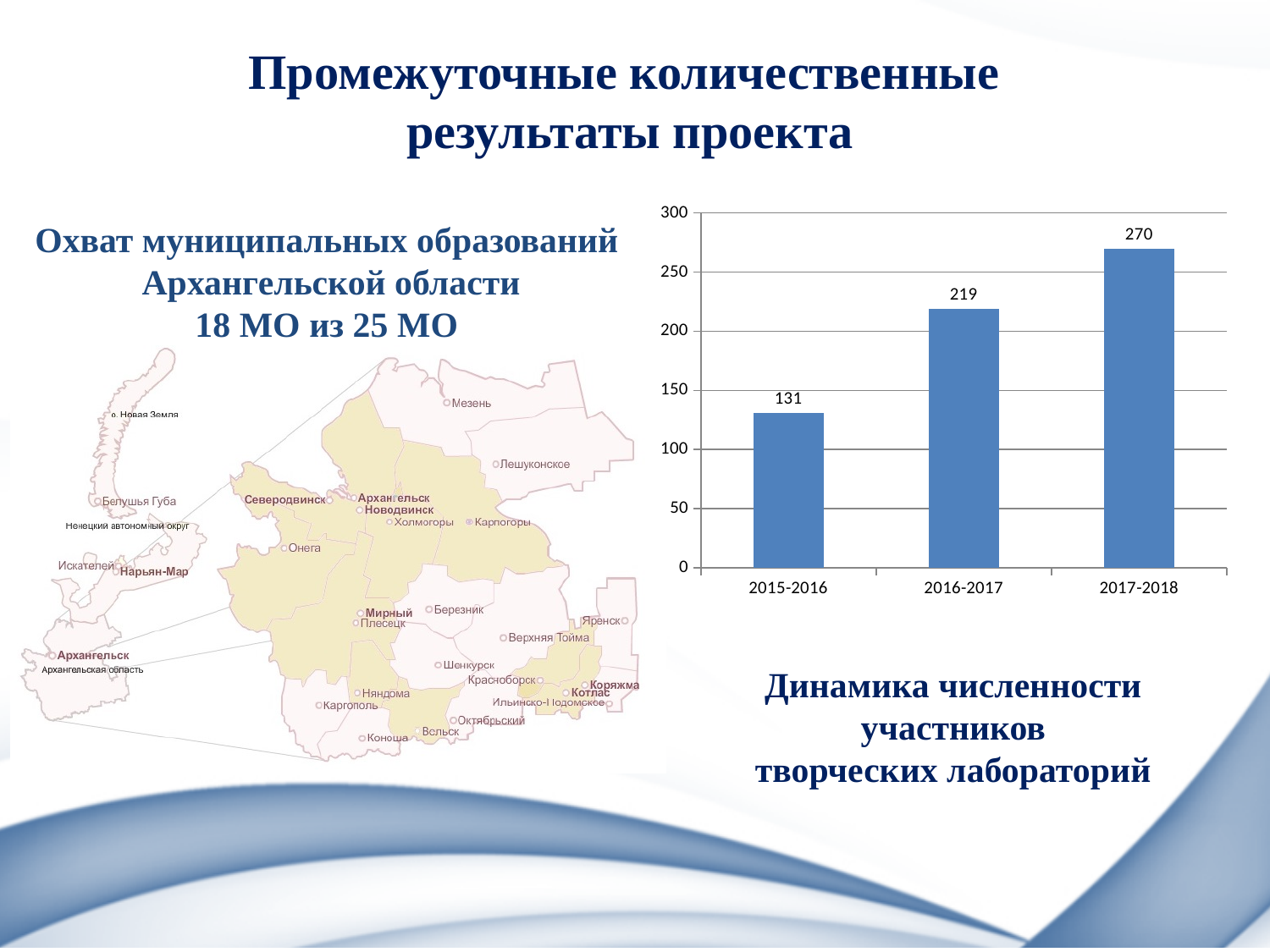
Which period has the lowest value? 2015-2016 What is the value for 2016-2017? 219 What kind of chart is shown? bar chart What is the difference between the values for 2017-2018 and 2015-2016? 139 What is the value for 2015-2016? 131 What is the difference between the values for 2016-2017 and 2015-2016? 88 Which is larger, the value for 2016-2017 or the value for 2015-2016? 2016-2017 Which period has the highest value? 2017-2018 Is the value for 2016-2017 greater or less than 200? greater How many periods are shown on the x axis? 3 Do the values rise or fall from 2015-2016 to 2017-2018? rise What is the value for 2017-2018? 270